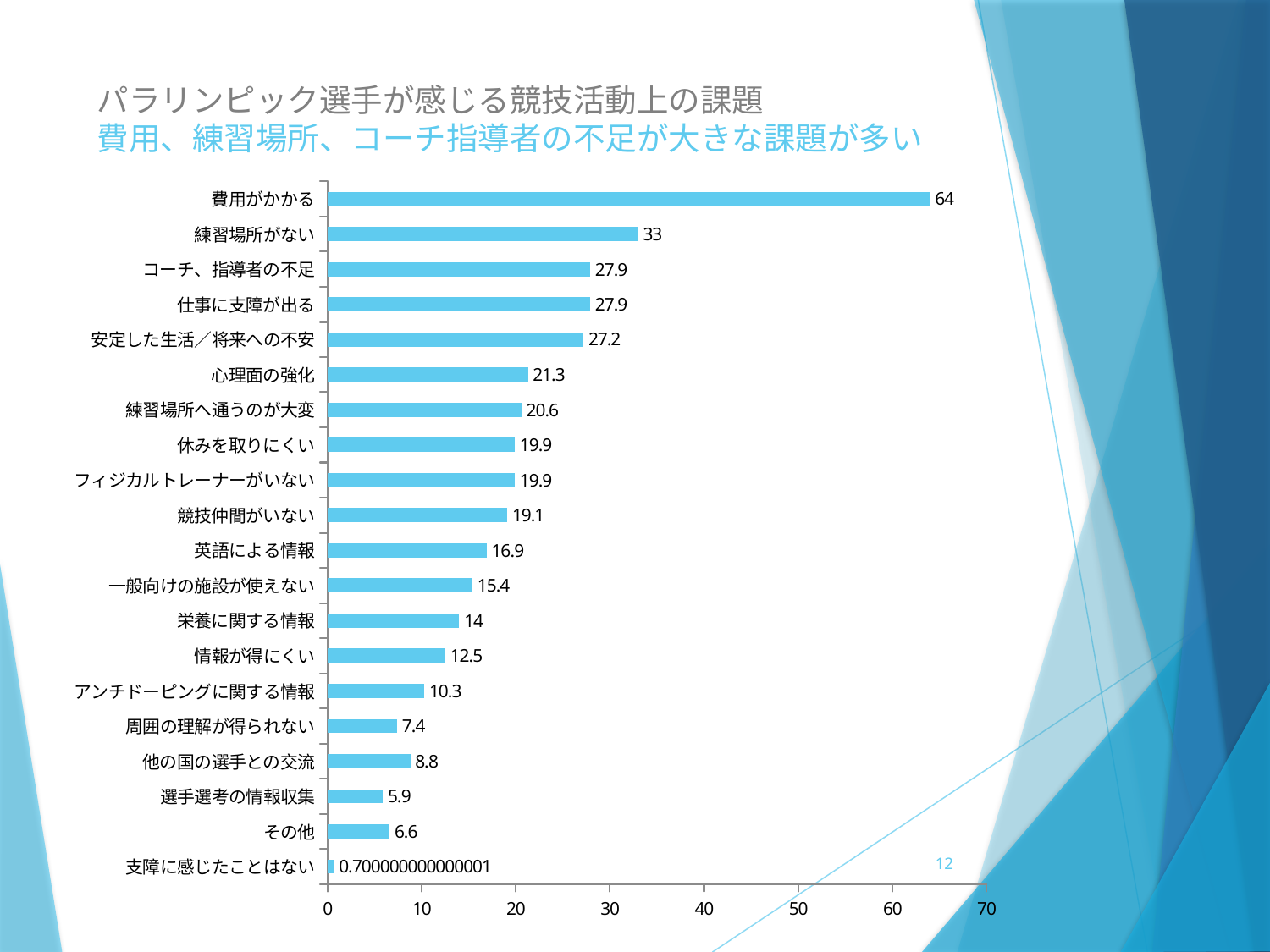
What is the value for 費用がかかる? 64 What is the value for 栄養に関する情報? 14 How many categories are shown in the chart? 20 Which is larger, the value for 周囲の理解が得られない or 他の国の選手との交流? 他の国の選手との交流 Which category has the highest value? 費用がかかる What is the value for 他の国の選手との交流? 8.8 Is the value for 心理面の強化 greater or less than 20? greater Which category has the lowest value? 支障に感じたことはない What is the value for 英語による情報? 16.9 What is the difference between the values for 費用がかかる and 練習場所がない? 31 What kind of chart is shown on the slide? bar chart What is the value for 練習場所がない? 33